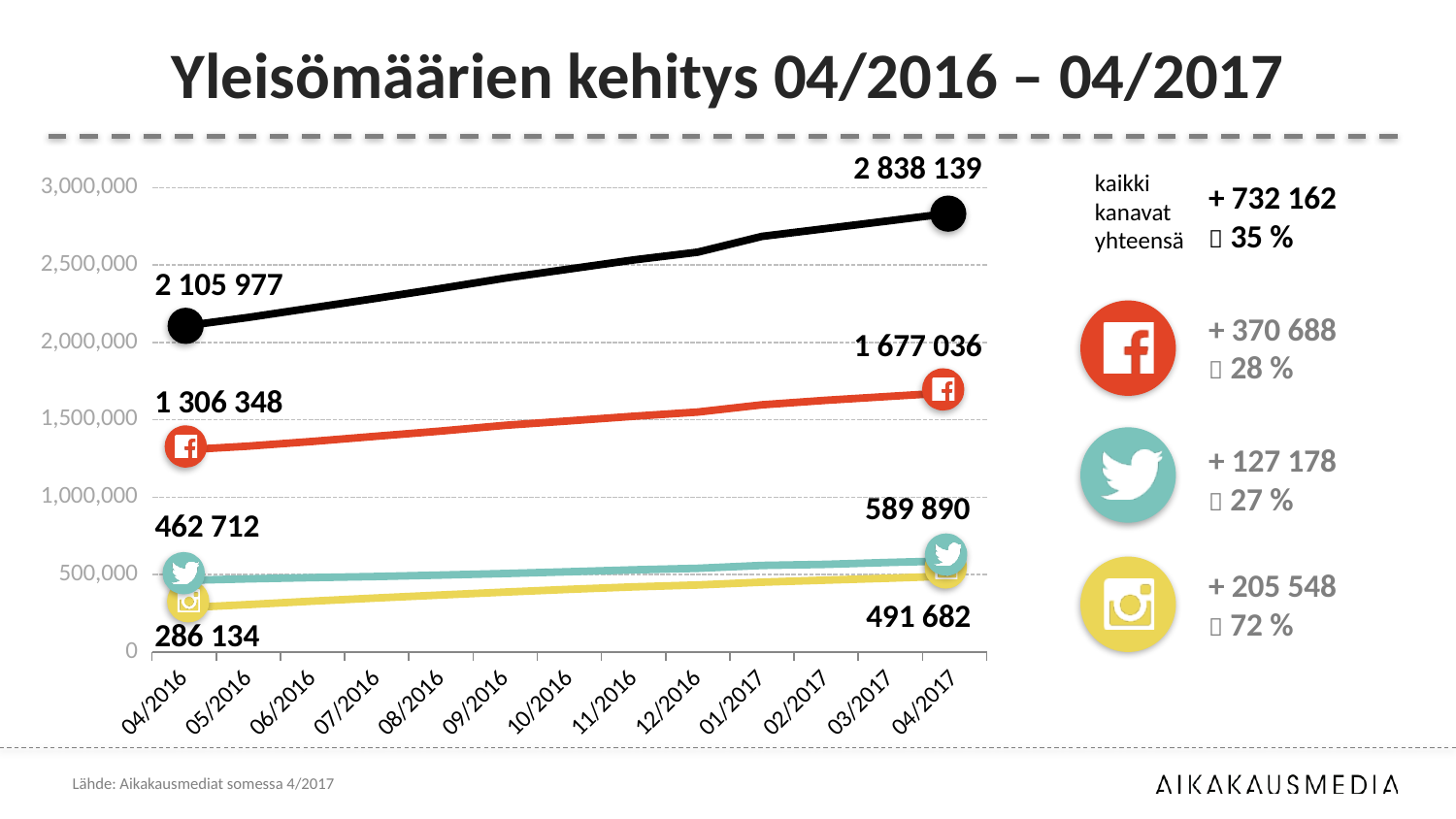
At 04/2017, which is larger: the teal Twitter line or the yellow Instagram line? Twitter (teal line) What is the value of the black (total) line at 04/2017? 2 838 139 What is the value of the yellow Instagram line at 04/2017? 491 682 By how much did the red Facebook line increase from 04/2016 to 04/2017? 370 688 Which line has the lowest value at 04/2016? Instagram (yellow line) What is the value of the red Facebook line at 04/2017? 1 677 036 How many months are shown on the x axis? 13 By how much did the yellow Instagram line increase from 04/2016 to 04/2017? 205 548 Is the value of the red Facebook line at 04/2016 greater or less than 1,500,000? less What is the value of the teal Twitter line at 04/2016? 462 712 What type of chart is shown on the slide? Line chart What is the value of the black (total) line at 04/2016? 2 105 977